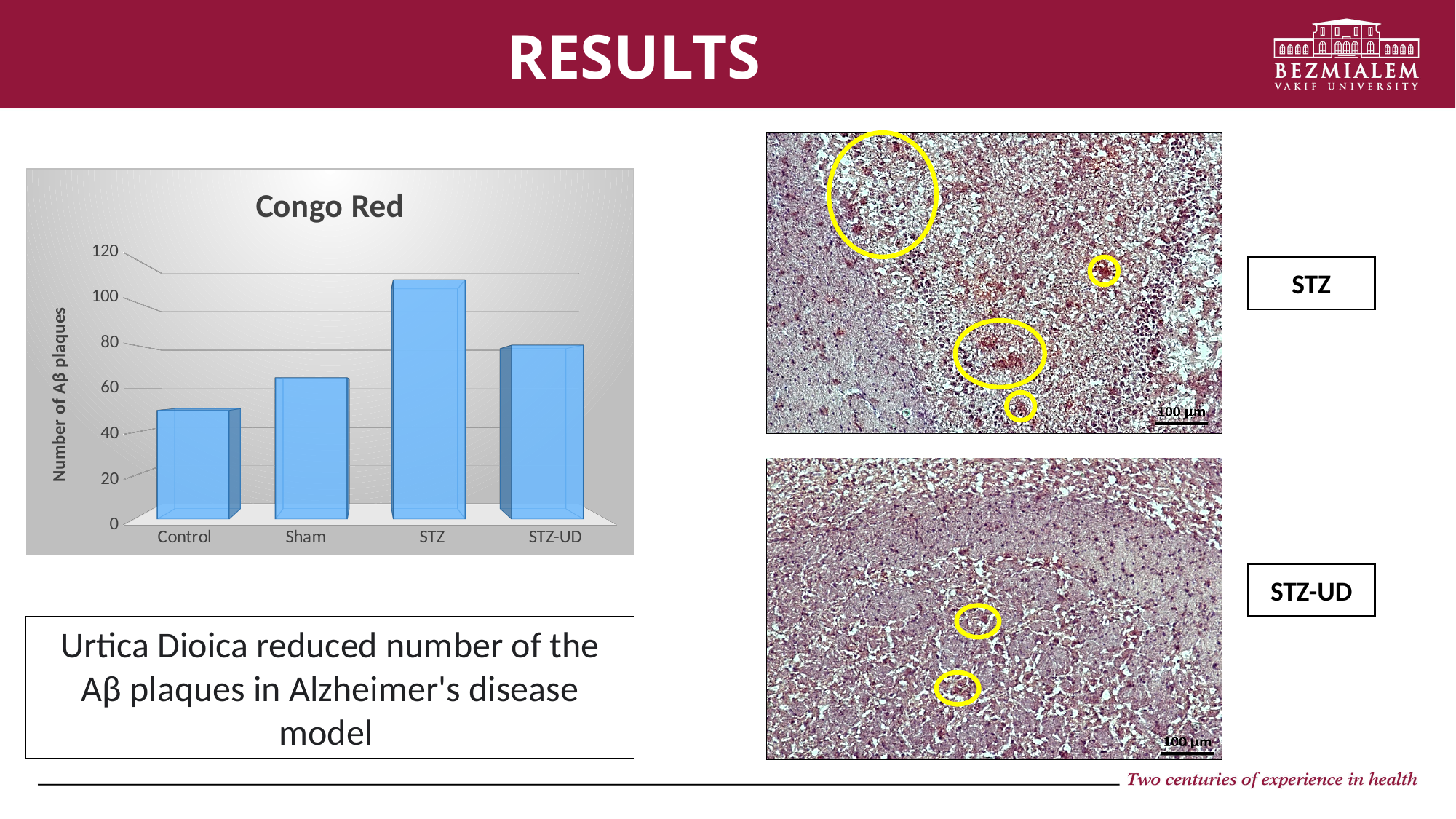
Which has a higher number of Aβ plaques, Sham or Control? Sham Is the value for Sham greater or less than 80? less How many categories are shown on the x axis of the chart? 4 Which has a higher number of Aβ plaques, STZ or STZ-UD? STZ What kind of chart is shown on the slide? bar chart What is the title of the chart? Congo Red Is the value for STZ-UD greater or less than 100? less What is the label of the vertical axis of the chart? Number of Aβ plaques Is the value for Control greater or less than 40? greater Which category has the highest number of Aβ plaques? STZ Which category has the lowest number of Aβ plaques? Control